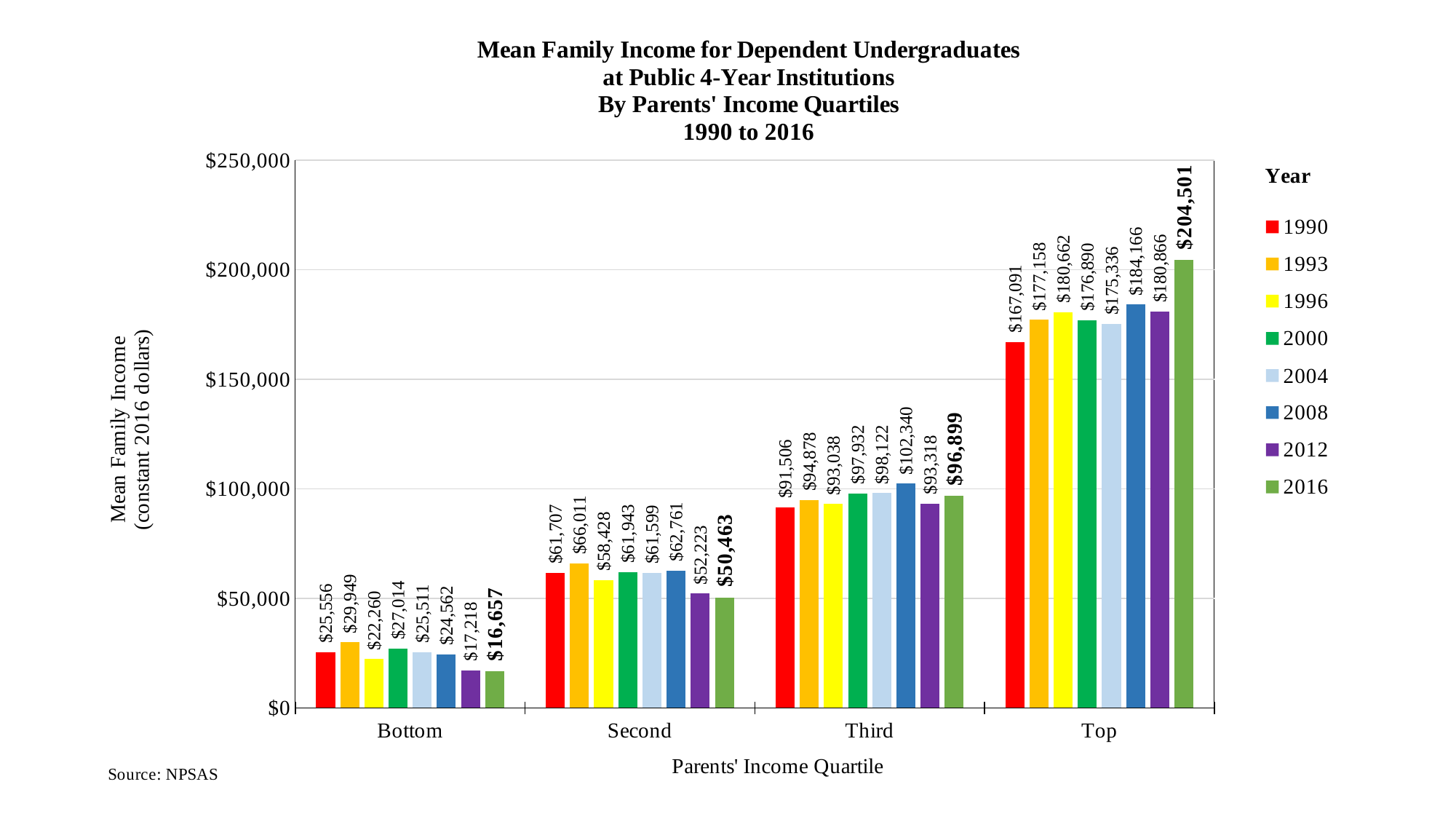
What is the mean family income for the Top quartile in 2016? $204,501 How much higher is the Top quartile's mean family income in 2016 than in 1990? $37,410 What is the mean family income for the Third quartile in 2008? $102,340 In the Top quartile, which year has the highest mean family income? 2016 What is the title of the legend? Year What is the mean family income for the Bottom quartile in 1990? $25,556 Is the mean family income for the Top quartile in 2016 greater or less than $200,000? greater How many parents' income quartiles are shown on the x axis? 4 What kind of chart is shown on the slide? bar chart In the Bottom quartile, which year has the lowest mean family income? 2016 In the Second quartile, which year has the larger mean family income, 1993 or 2016? 1993 How many years does the legend list? 8